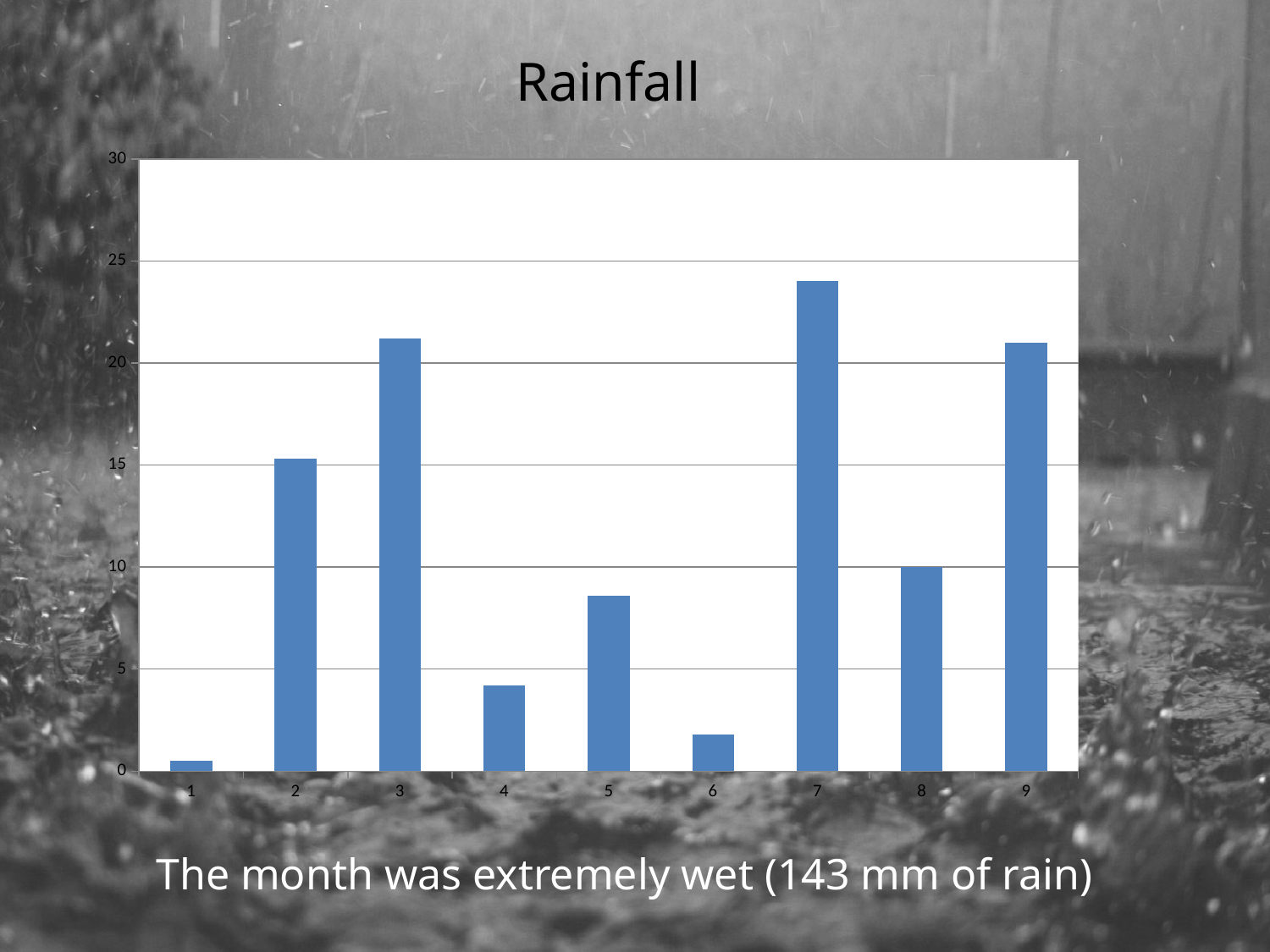
Is the value for category 4 greater or less than 5? less How many categories are plotted along the x axis? 9 Which is larger, the value for category 3 or the value for category 5? 3 Is the value for category 5 greater or less than 10? less What is the title of the chart? Rainfall Which is larger, the value for category 2 or the value for category 8? 2 Is the value for category 6 greater or less than 5? less Which category has the highest bar? 7 Which category has the lowest bar? 1 What kind of chart is shown on the slide? bar chart